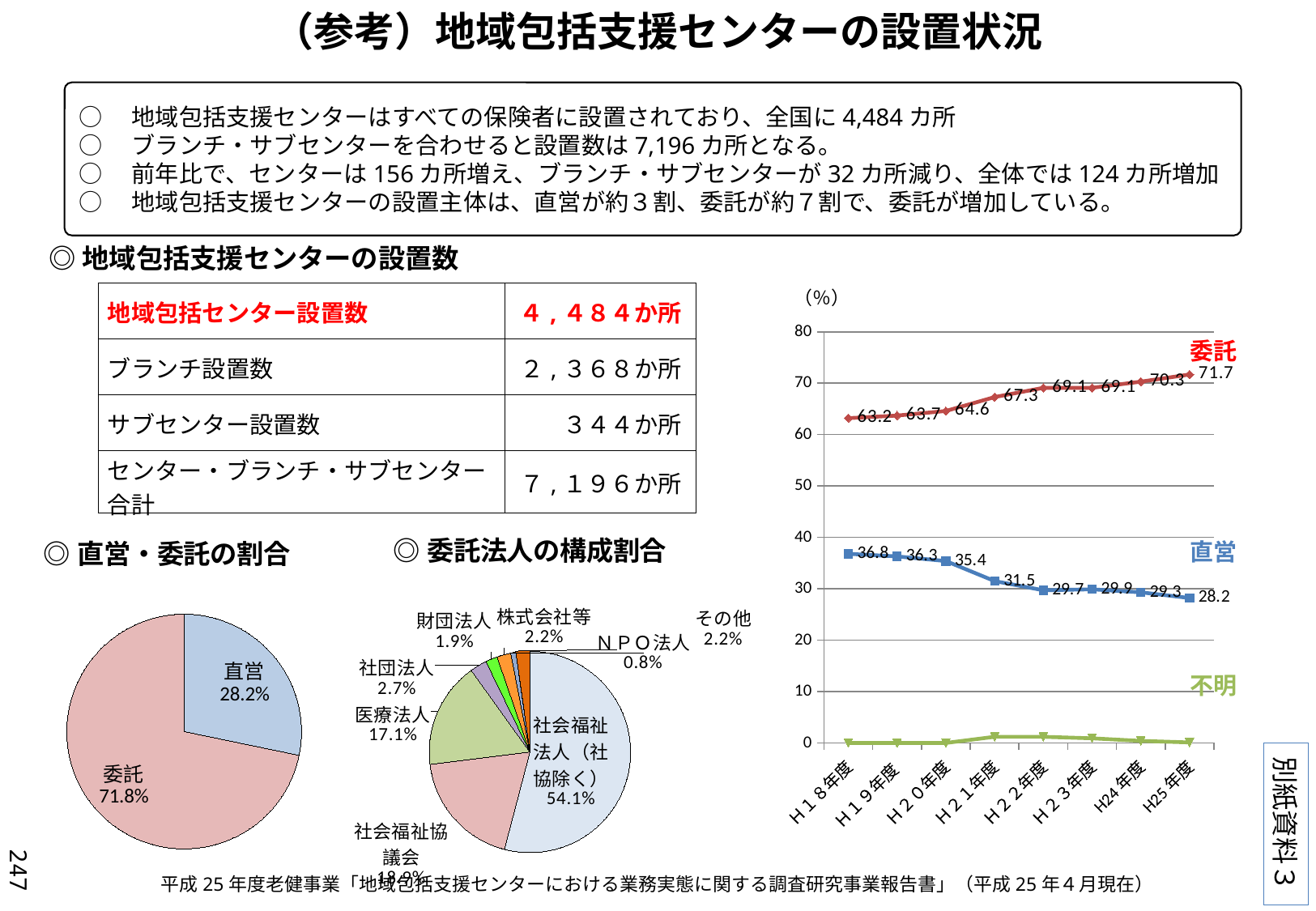
In the line chart on the right, does the 委託 line rise or fall from H18年度 to H25年度? rises In the line chart on the right, what is the value for 直営 in H18年度? 36.8 In the pie chart titled 委託法人の構成割合, what is the share for 医療法人? 17.1% In the line chart on the right, how many series are plotted? 3 In the line chart on the right, how many fiscal years are shown on the x axis? 8 In the pie chart titled 直営・委託の割合, what share does 委託 have? 71.8% In the line chart on the right, is the value for 不明 in H22年度 greater or less than 10? less What kind of chart is the chart on the right showing 委託, 直営 and 不明? line chart In the line chart on the right, does the 直営 line rise or fall from H18年度 to H25年度? falls In the pie chart titled 委託法人の構成割合, which category has the largest share? 社会福祉法人（社協除く） In the line chart on the right, by how much did the 委託 value increase from H18年度 (63.2) to H25年度 (71.7)? 8.5 In the line chart on the right, what is the value for 委託 in H25年度? 71.7